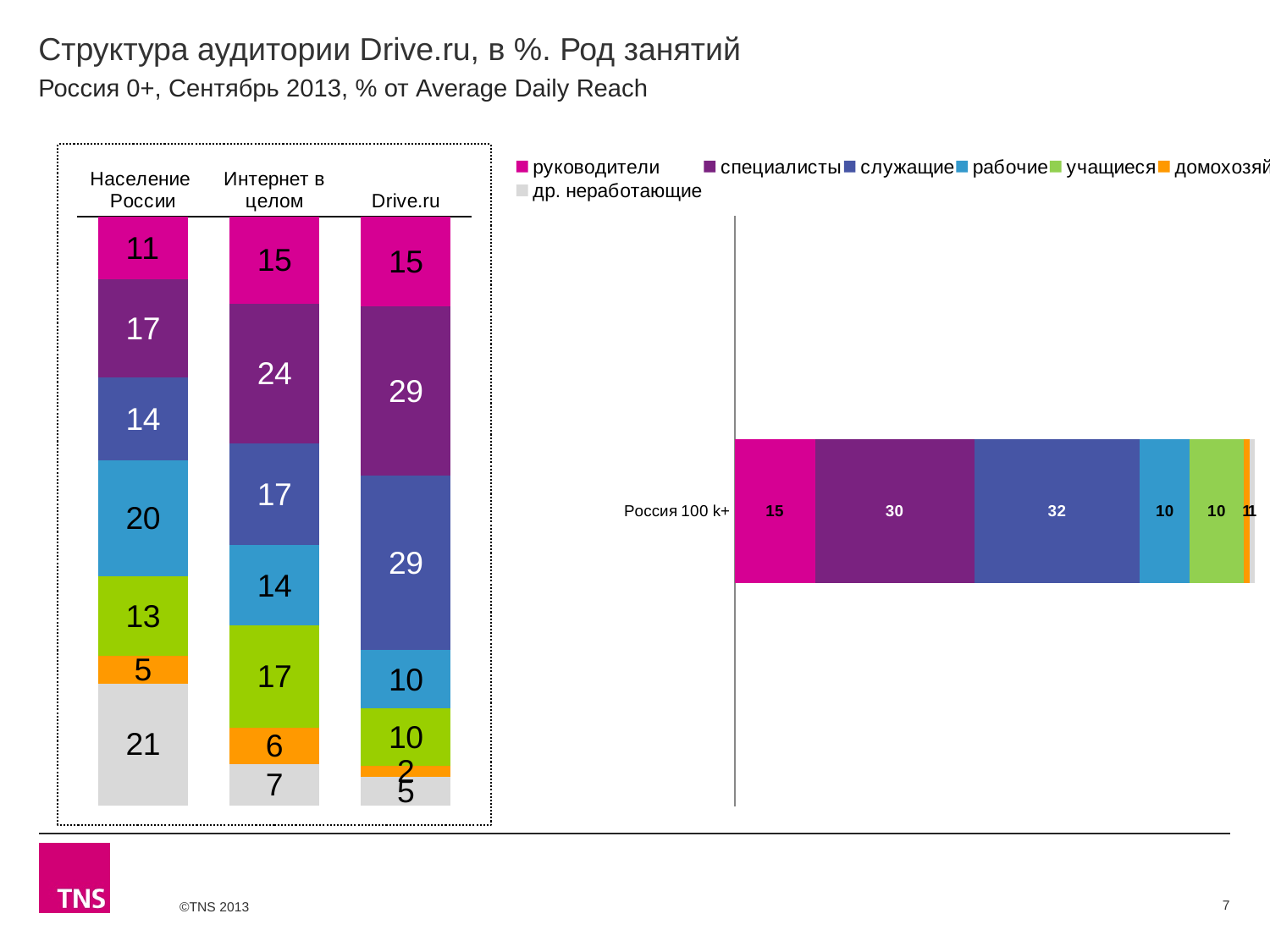
In the right chart (Россия 100 k+), which segment has the highest value? служащие In the left chart, which segment is the largest in the Население России bar? др. неработающие In the left chart, what is the value for специалисты in the Drive.ru bar? 29 In the right chart (Россия 100 k+), what is the value for служащие? 32 What kind of chart is the right chart (Россия 100 k+)? Stacked bar chart In the left chart, what is the value for руководители in the Интернет в целом bar? 15 How many bars (categories) does the left chart show? 3 How many series does the legend list? 7 In the left chart, what is the difference between the специалисты value for Drive.ru and for Население России? 18 In the left chart, what is the value for др. неработающие in the Население России bar? 21 In the left chart, what is the total of the Drive.ru stacked bar? 100 In the left chart, which has a larger рабочие value: Население России or Drive.ru? Население России